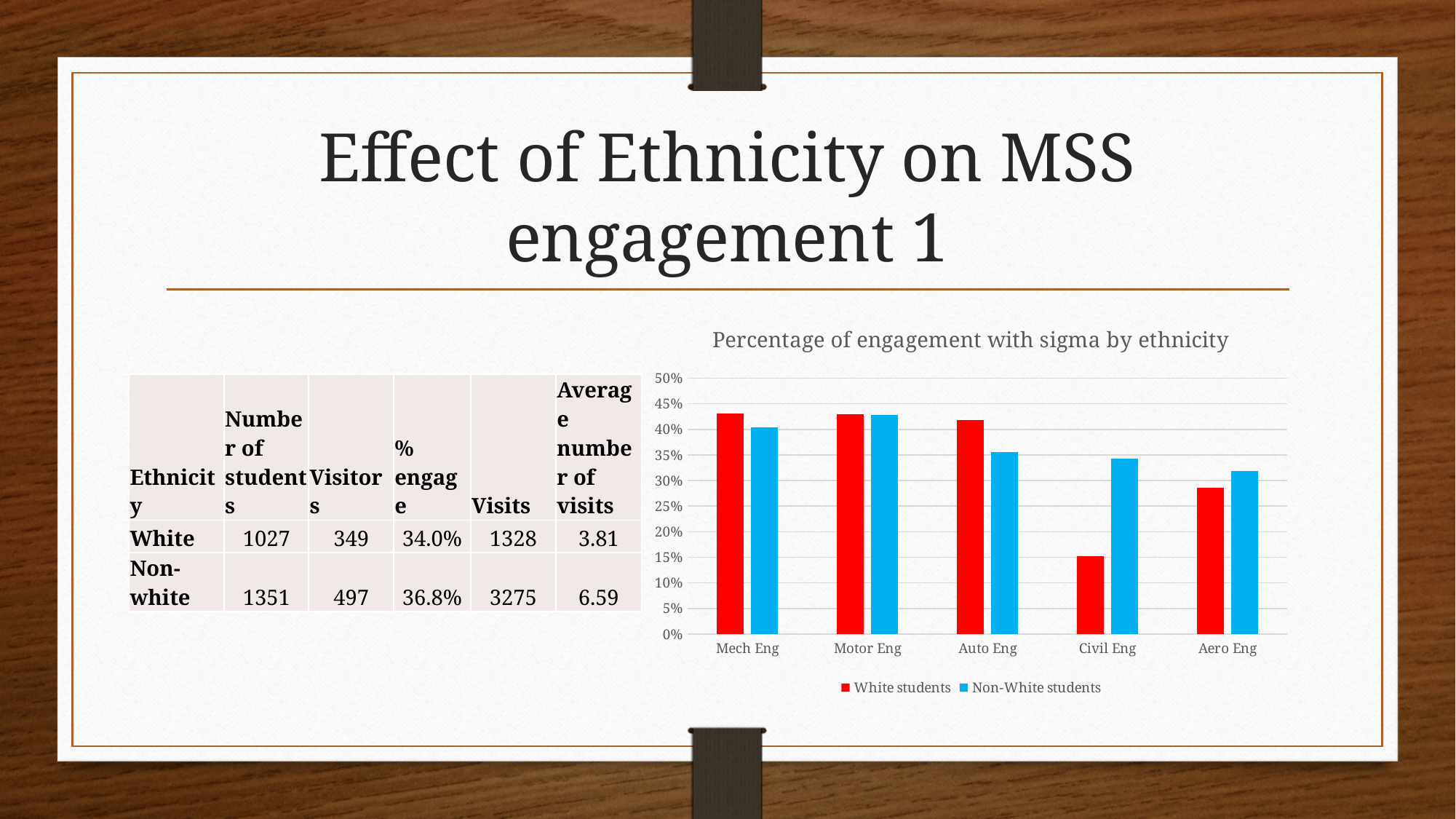
In Auto Eng, which is larger: the value for White students or for Non-White students? White students Is the value for Non-White students in Civil Eng greater or less than 30%? greater In Civil Eng, which is larger: the value for White students or for Non-White students? Non-White students What is the title of the chart? Percentage of engagement with sigma by ethnicity Is the value for White students in Civil Eng greater or less than 20%? less How many departments are shown on the x axis of the chart? 5 How many series does the chart's legend list? 2 For which department is the value for White students lowest? Civil Eng Is the value for White students in Aero Eng greater or less than 30%? less What kind of chart is shown on the slide? bar chart For which department is the value for Non-White students highest? Motor Eng Which colour represents Non-White students in the chart? blue